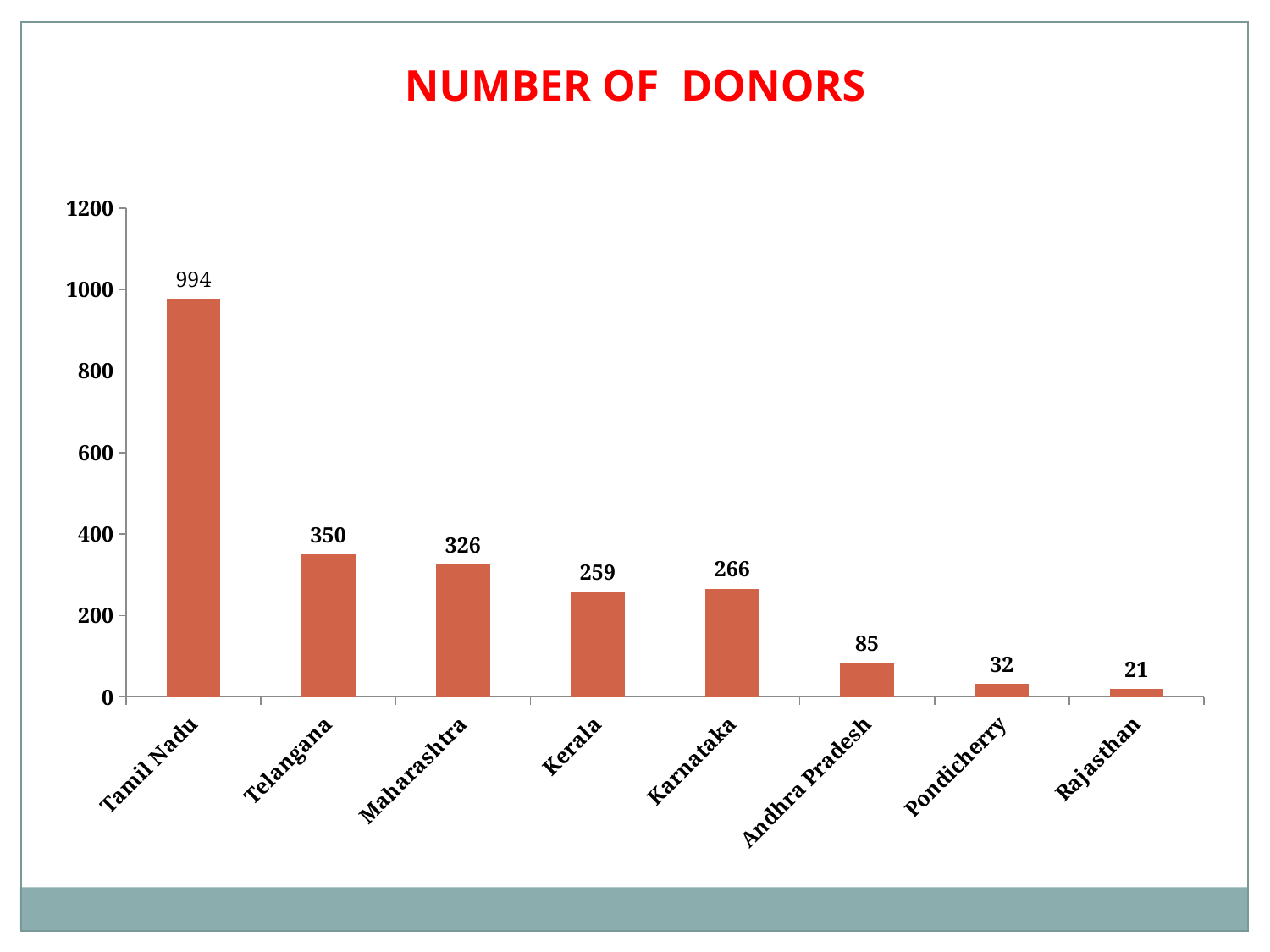
Which state has the highest number of donors? Tamil Nadu What is the number of donors for Tamil Nadu? 994 How many states or territories are shown in the chart? 8 What is the difference in number of donors between Telangana and Maharashtra? 24 What is the title of the chart? NUMBER OF DONORS What is the number of donors for Maharashtra? 326 What is the number of donors for Pondicherry? 32 Is the value for Andhra Pradesh greater or less than 200? less Which has more donors, Kerala or Karnataka? Karnataka What is the difference in number of donors between Tamil Nadu and Telangana? 644 Which state has the lowest number of donors? Rajasthan What kind of chart is shown on the slide? bar chart